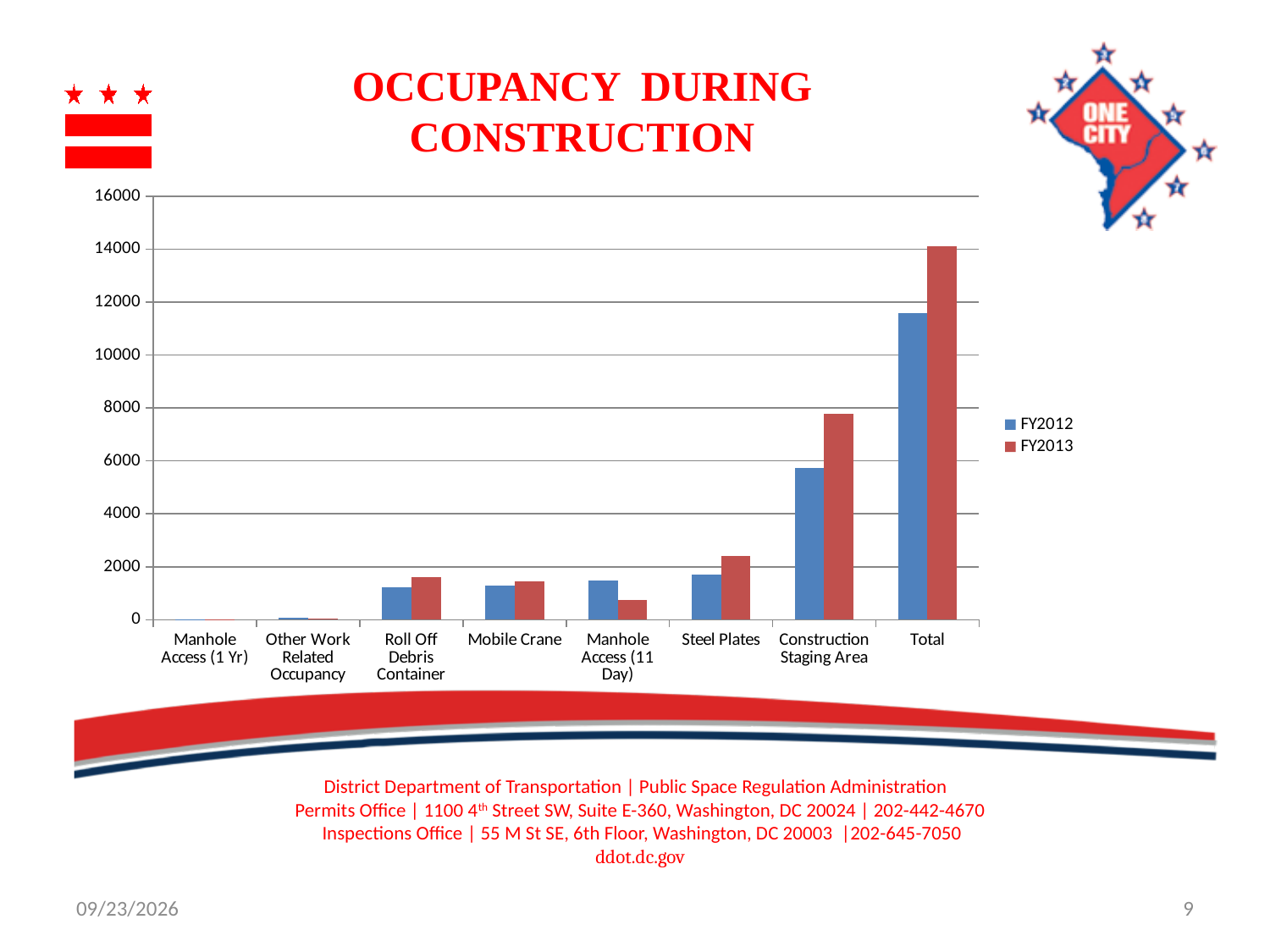
What kind of chart is shown on the slide? bar chart Is the FY2013 value for Construction Staging Area greater or less than 6000? greater What is the title of the chart? OCCUPANCY DURING CONSTRUCTION How many series does the legend list? 2 Excluding Total, which category has the highest FY2012 value? Construction Staging Area Is the FY2013 value for Steel Plates greater or less than 2000? greater Which category has the highest FY2013 value? Total Is the FY2012 value for Construction Staging Area greater or less than 6000? less How many categories are shown on the x axis? 8 For Manhole Access (11 Day), which series has the larger value, FY2012 or FY2013? FY2012